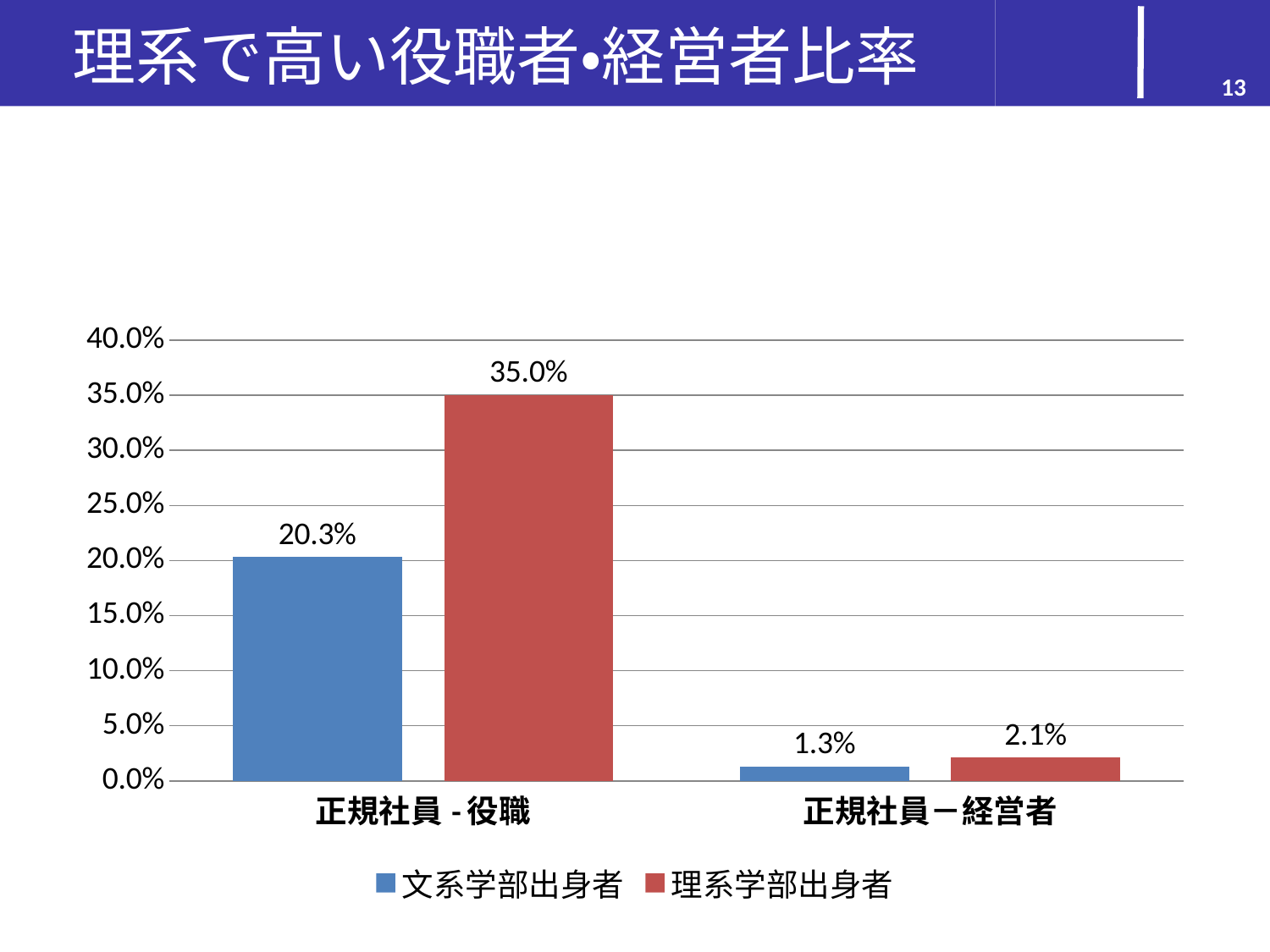
What kind of chart is shown on the slide? Bar chart What is the value for 理系学部出身者 in the 正規社員 - 役職 category? 35.0% How many series does the legend list? 2 How many categories are shown on the x axis? 2 What is the value for 文系学部出身者 in the 正規社員 - 役職 category? 20.3% What is the value for 理系学部出身者 in the 正規社員－経営者 category? 2.1% What is the difference between 理系学部出身者 and 文系学部出身者 in the 正規社員－経営者 category? 0.8% Which bar has the lowest value on the chart? 文系学部出身者, 正規社員－経営者 What is the value for 文系学部出身者 in the 正規社員－経営者 category? 1.3% What is the difference between 理系学部出身者 and 文系学部出身者 in the 正規社員 - 役職 category? 14.7% Which bar has the highest value on the chart? 理系学部出身者, 正規社員 - 役職 In the 正規社員 - 役職 category, which series has the larger value, 文系学部出身者 or 理系学部出身者? 理系学部出身者